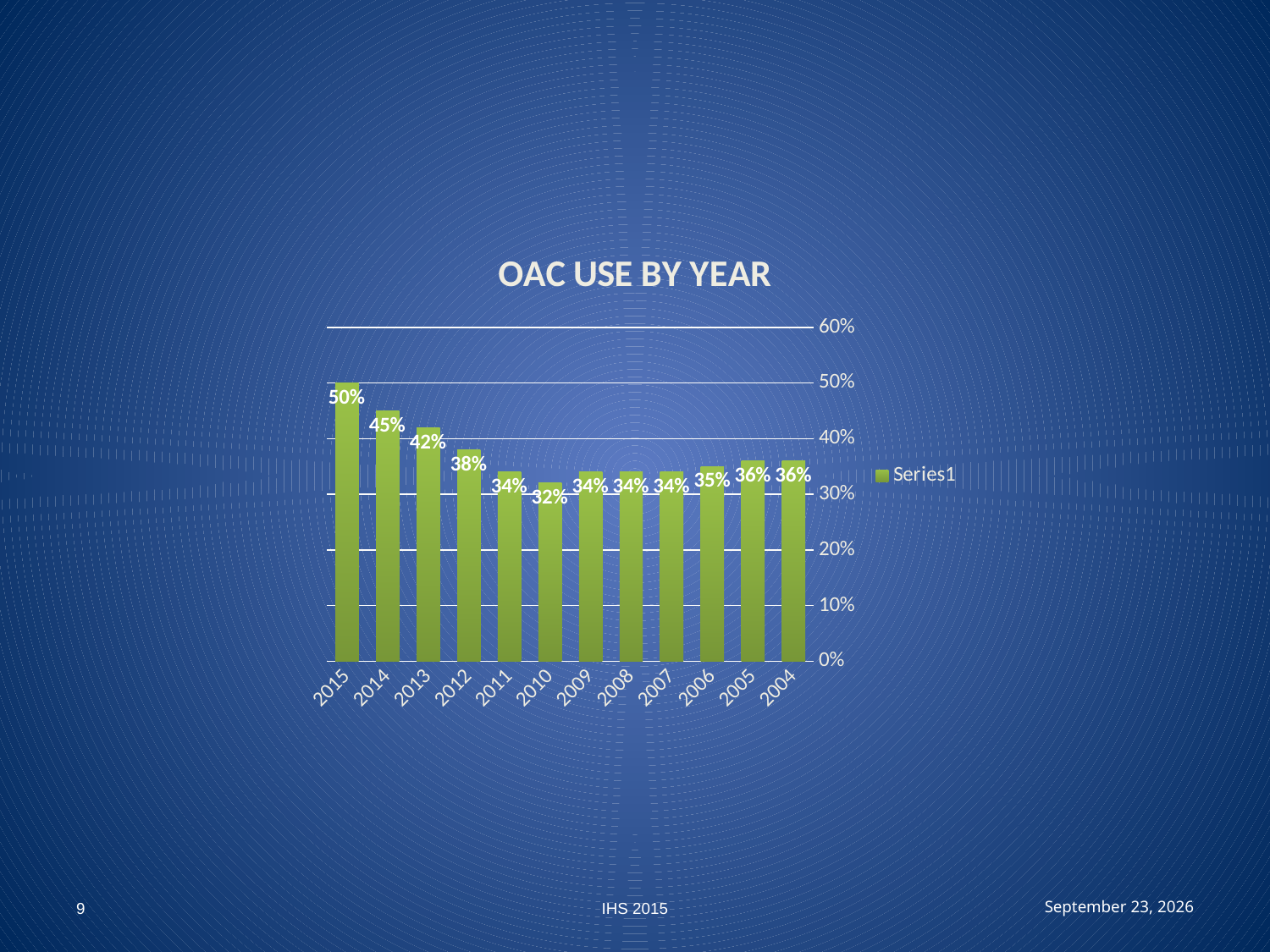
How many years are shown on the x axis? 12 What is the title of the chart? OAC USE BY YEAR What is the value for 2012? 38% What is the difference between the values for 2015 and 2014? 5% What kind of chart is this? bar chart What is the difference between the values for 2013 and 2010? 10% Which year has the highest value? 2015 What is the value for 2010? 32% What is the value for 2015? 50% Which year has the lowest value? 2010 Which is larger, the value for 2014 or the value for 2005? 2014 Is the value for 2013 greater or less than 40%? greater